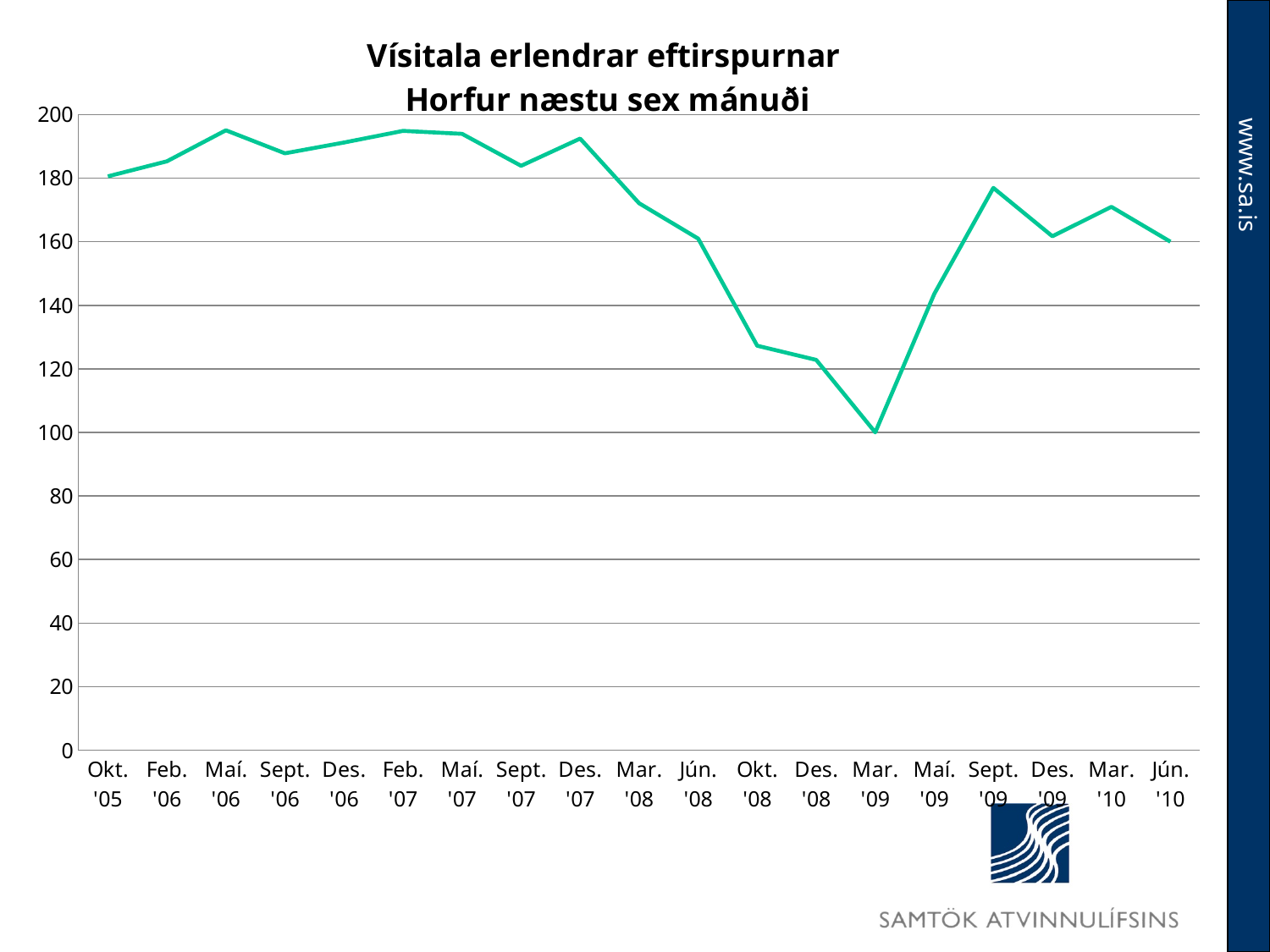
How many data points are plotted along the x axis? 19 Do the values rise or fall between Des. '07 and Mar. '09? fall Which is larger, the value for Mar. '08 or the value for Okt. '08? Mar. '08 Is the value for Feb. '06 greater or less than 180? greater Which period has the lowest value on the chart? Mar. '09 What kind of chart is shown on the slide? line chart Is the value for Okt. '08 greater or less than 140? less Which is larger, the value for Sept. '09 or the value for Des. '09? Sept. '09 Is the value for Sept. '09 greater or less than 180? less What is the title of the chart? Vísitala erlendrar eftirspurnar Horfur næstu sex mánuði